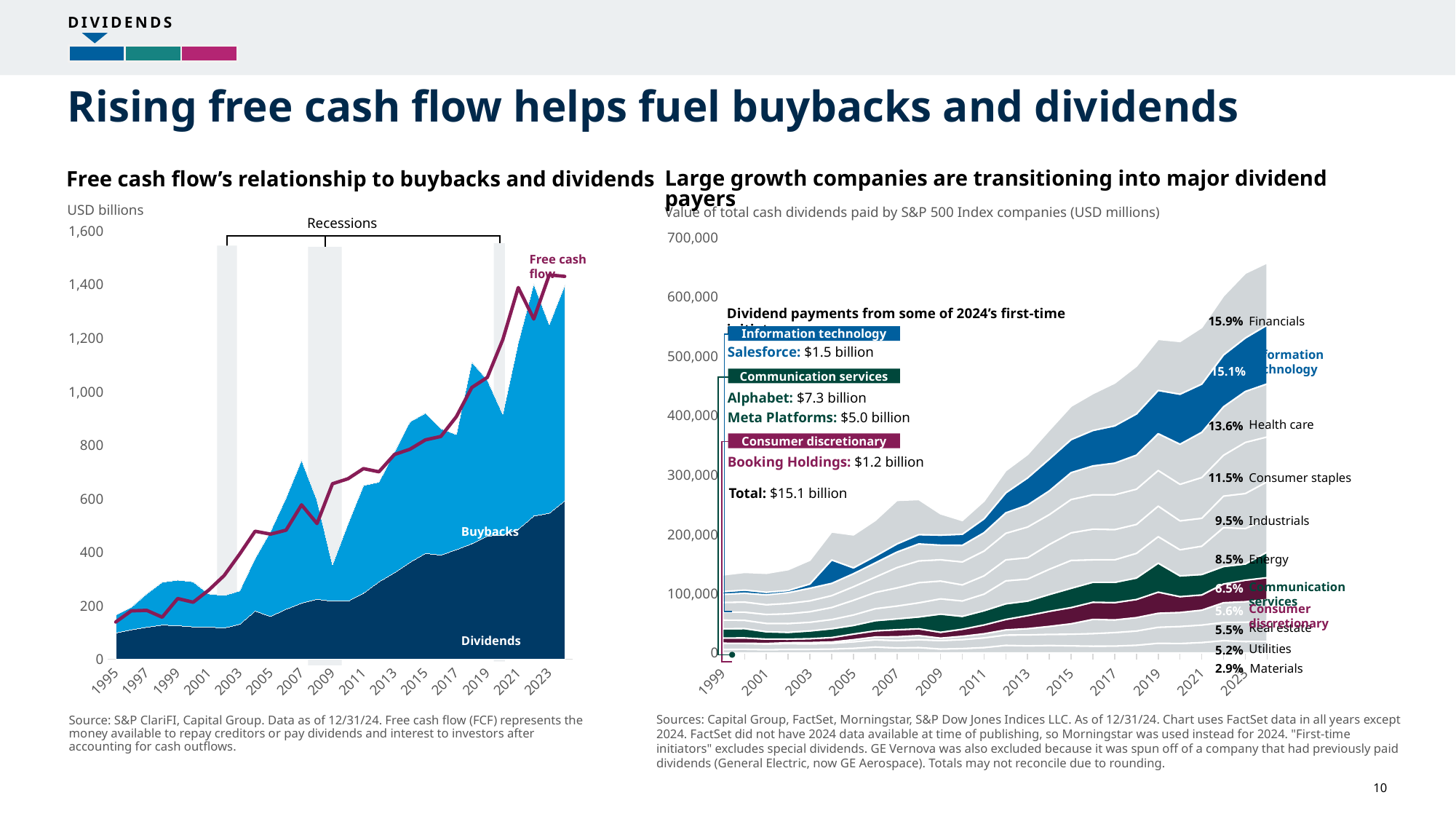
In the chart 'Large growth companies are transitioning into major dividend payers', what is the total dividend payment listed for the 2024 first-time initiators? $15.1 billion In the chart 'Free cash flow's relationship to buybacks and dividends', is the Dividends value in 2023 greater or less than 800? less In the chart 'Large growth companies are transitioning into major dividend payers', which sector has the lowest share label? Materials In the chart 'Large growth companies are transitioning into major dividend payers', how many sectors are labeled with a percentage? 11 In the chart 'Large growth companies are transitioning into major dividend payers', which first-time initiator paid more, Salesforce or Booking Holdings? Salesforce In the chart 'Large growth companies are transitioning into major dividend payers', what share is shown for Financials? 15.9% In the chart 'Large growth companies are transitioning into major dividend payers', what dividend payment is listed for Alphabet? $7.3 billion In the chart 'Large growth companies are transitioning into major dividend payers', which sector has the highest share label? Financials In the chart 'Free cash flow's relationship to buybacks and dividends', is the free cash flow value in 2023 greater or less than 1,200? greater In the chart 'Large growth companies are transitioning into major dividend payers', which has the larger share label, Health care or Consumer staples? Health care In the chart 'Free cash flow's relationship to buybacks and dividends', do Dividends generally rise or fall from 1995 to 2023? rise In the chart 'Large growth companies are transitioning into major dividend payers', what is the difference between the Financials share and the Information technology share? 0.8%